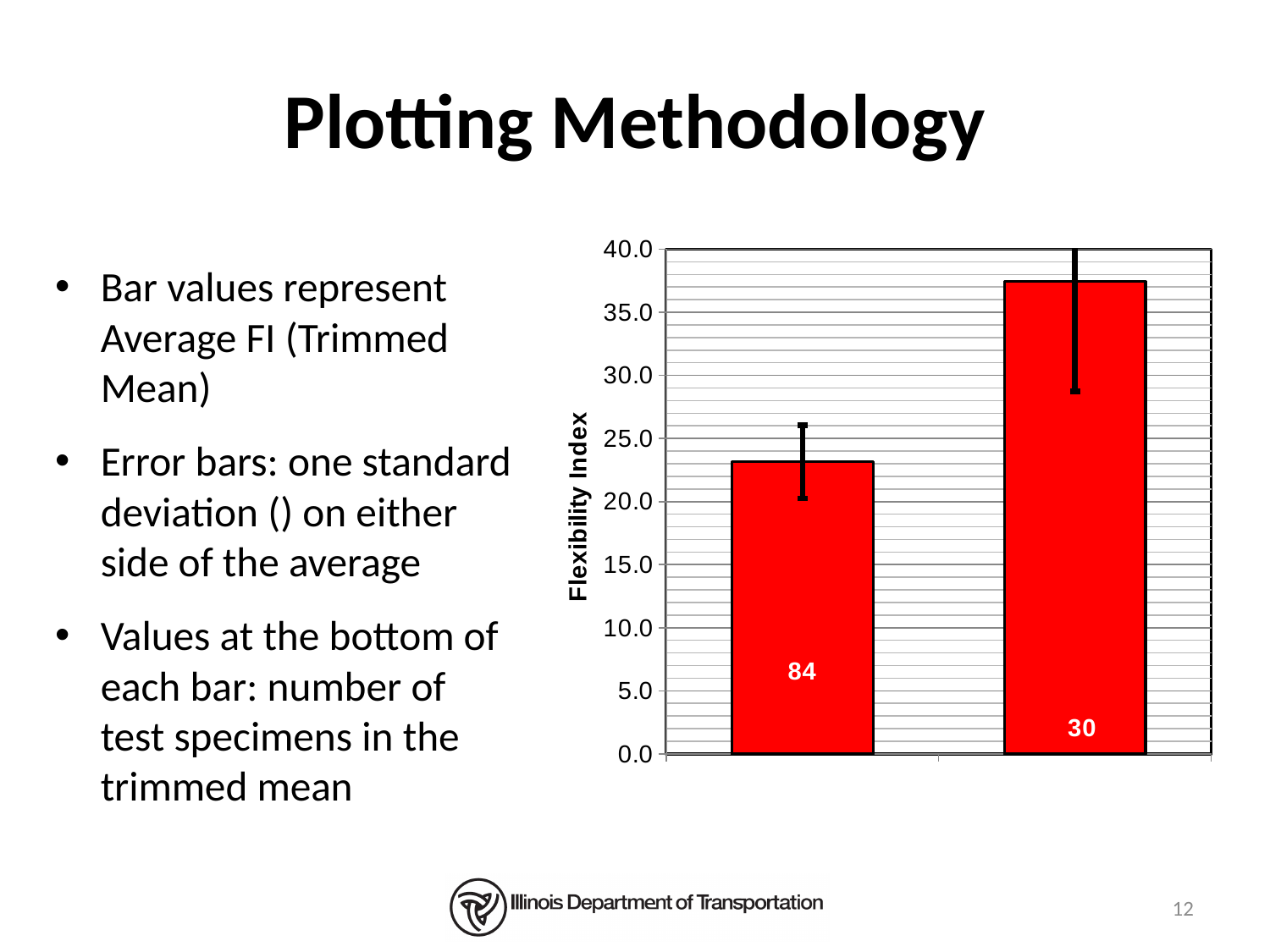
Is the Flexibility Index value of the right bar greater or less than 40.0? less What number is printed at the bottom of the right bar? 30 Which bar is taller, the left bar or the right bar? the right bar What type of chart is shown on the slide? bar chart Is the Flexibility Index value of the right bar greater or less than 35.0? greater How many bars are plotted in the chart? 2 Is the Flexibility Index value of the left bar greater or less than 20.0? greater What number is printed at the bottom of the left bar? 84 Which bar has the lower Flexibility Index, the left bar or the right bar? the left bar What is the maximum value shown on the vertical axis of the chart? 40.0 What is the label on the vertical axis of the chart? Flexibility Index